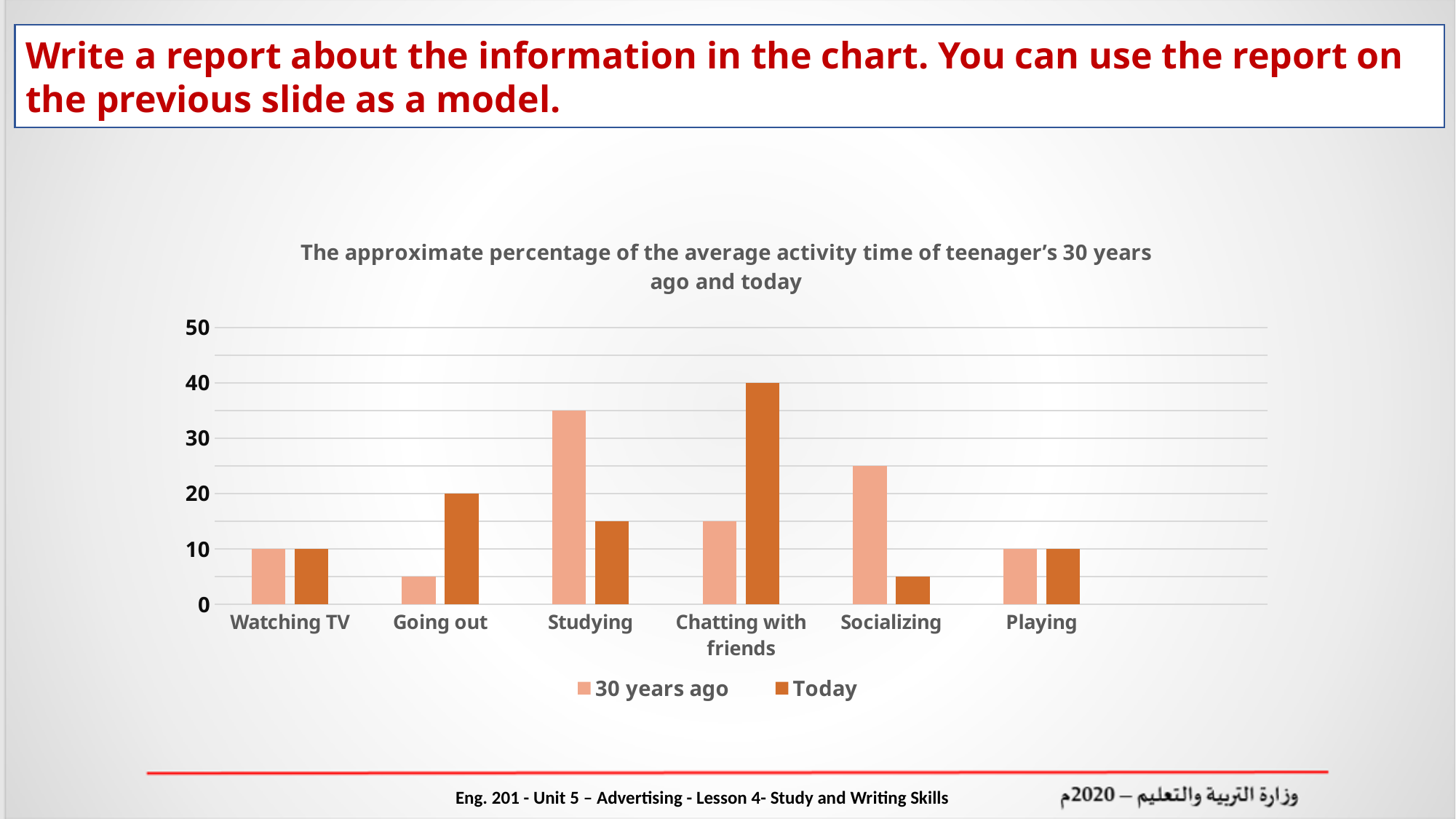
What are the two entries in the chart's legend? 30 years ago, Today What is the value for Chatting with friends in the Today series? 40 How many activity categories are shown on the x axis? 6 Which activity has the lowest value in the Today series? Socializing Which is larger for Socializing: the 30 years ago value or the Today value? 30 years ago Is the value for Studying in the 30 years ago series greater or less than 30? greater How many series does the legend list? 2 What is the value for Going out in the Today series? 20 What kind of chart is shown on the slide? bar chart Which activity has the highest value in the Today series? Chatting with friends Which activity has the highest value in the 30 years ago series? Studying What is the value for Watching TV in the 30 years ago series? 10